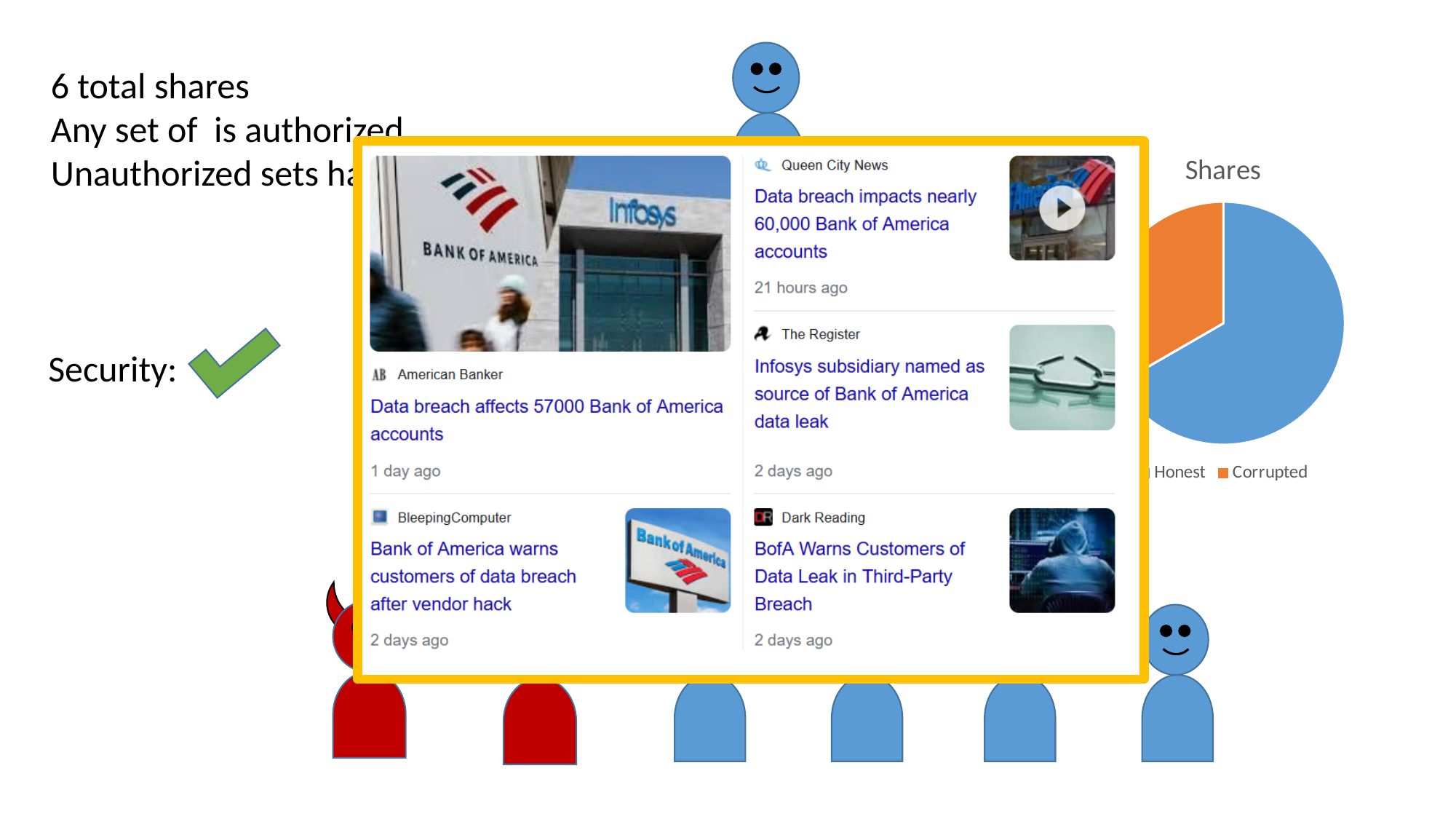
In the "Shares" pie chart, which is larger, the Honest slice or the Corrupted slice? Honest How many entries does the legend of the "Shares" pie chart list? 2 What colour is the Corrupted slice in the "Shares" pie chart? orange Which slice of the "Shares" pie chart is the smallest? Corrupted Which slice of the "Shares" pie chart is the largest? Honest What kind of chart is the "Shares" chart? pie chart How many slices does the "Shares" pie chart have? 2 What is the title of the pie chart? Shares